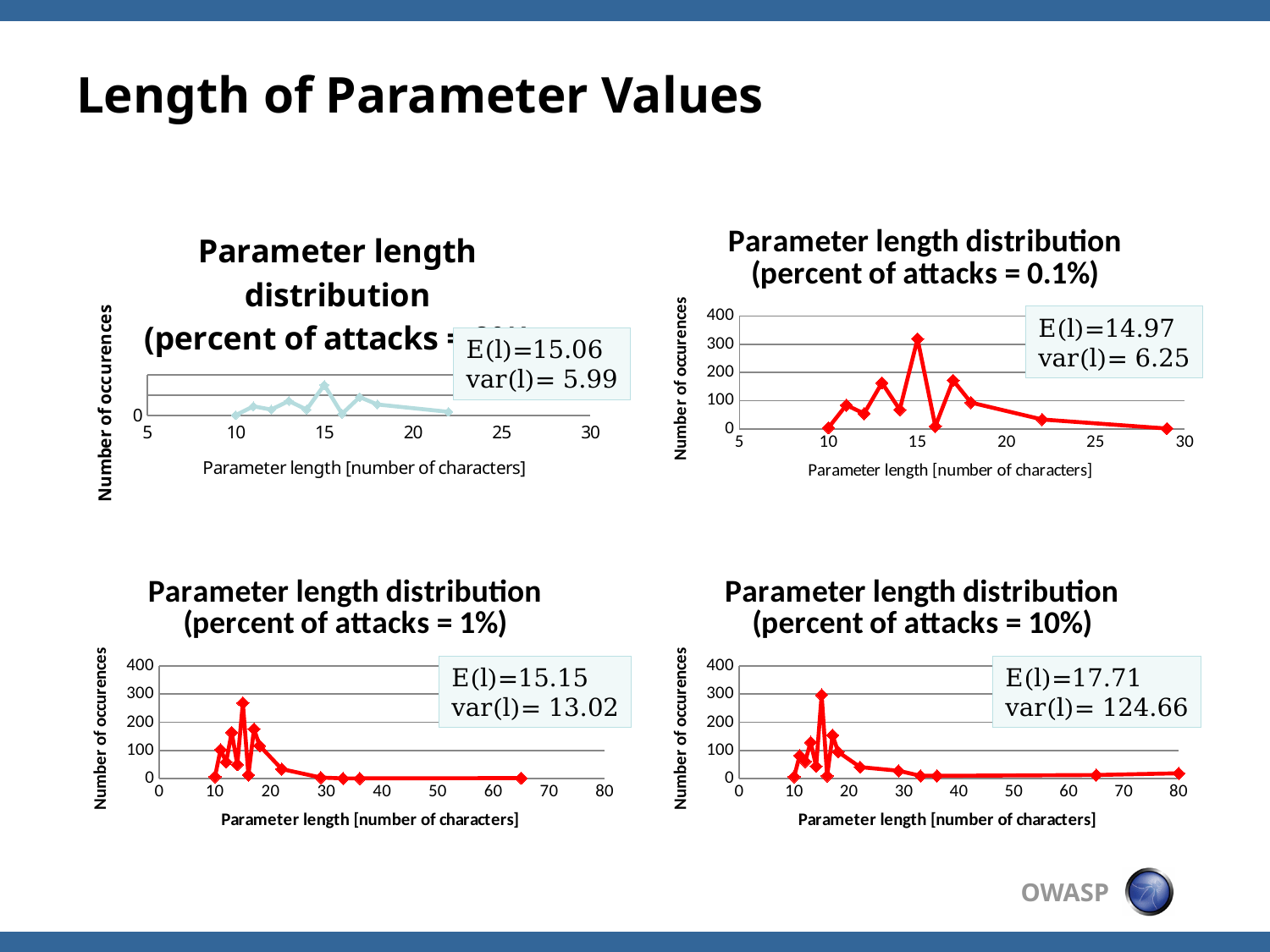
What value of var(l) is shown on the 'Parameter length distribution (percent of attacks = 1%)' chart? 13.02 In the 'Parameter length distribution (percent of attacks = 10%)' chart, at which parameter length is the number of occurrences highest? 15 How many charts are shown on the slide? 4 In the 'Parameter length distribution (percent of attacks = 1%)' chart, is the number of occurrences at parameter length 30 greater or less than 100? less In the 'Parameter length distribution (percent of attacks = 1%)' chart, at which parameter length is the number of occurrences highest? 15 In the 'Parameter length distribution (percent of attacks = 0.1%)' chart, which has more occurrences: parameter length 15 or parameter length 22? 15 What value of E(l) is shown on the 'Parameter length distribution (percent of attacks = 10%)' chart? 17.71 What kind of chart is the 'Parameter length distribution (percent of attacks = 0.1%)' chart? line chart In the 'Parameter length distribution (percent of attacks = 0.1%)' chart, do the values rise or fall as parameter length goes from 18 to 30? fall In the 'Parameter length distribution (percent of attacks = 10%)' chart, is the number of occurrences at parameter length 15 greater or less than 200? greater In the 'Parameter length distribution (percent of attacks = 0.1%)' chart, at which parameter length is the number of occurrences highest? 15 In the 'Parameter length distribution (percent of attacks = 0.1%)' chart, is the number of occurrences at parameter length 15 greater or less than 200? greater